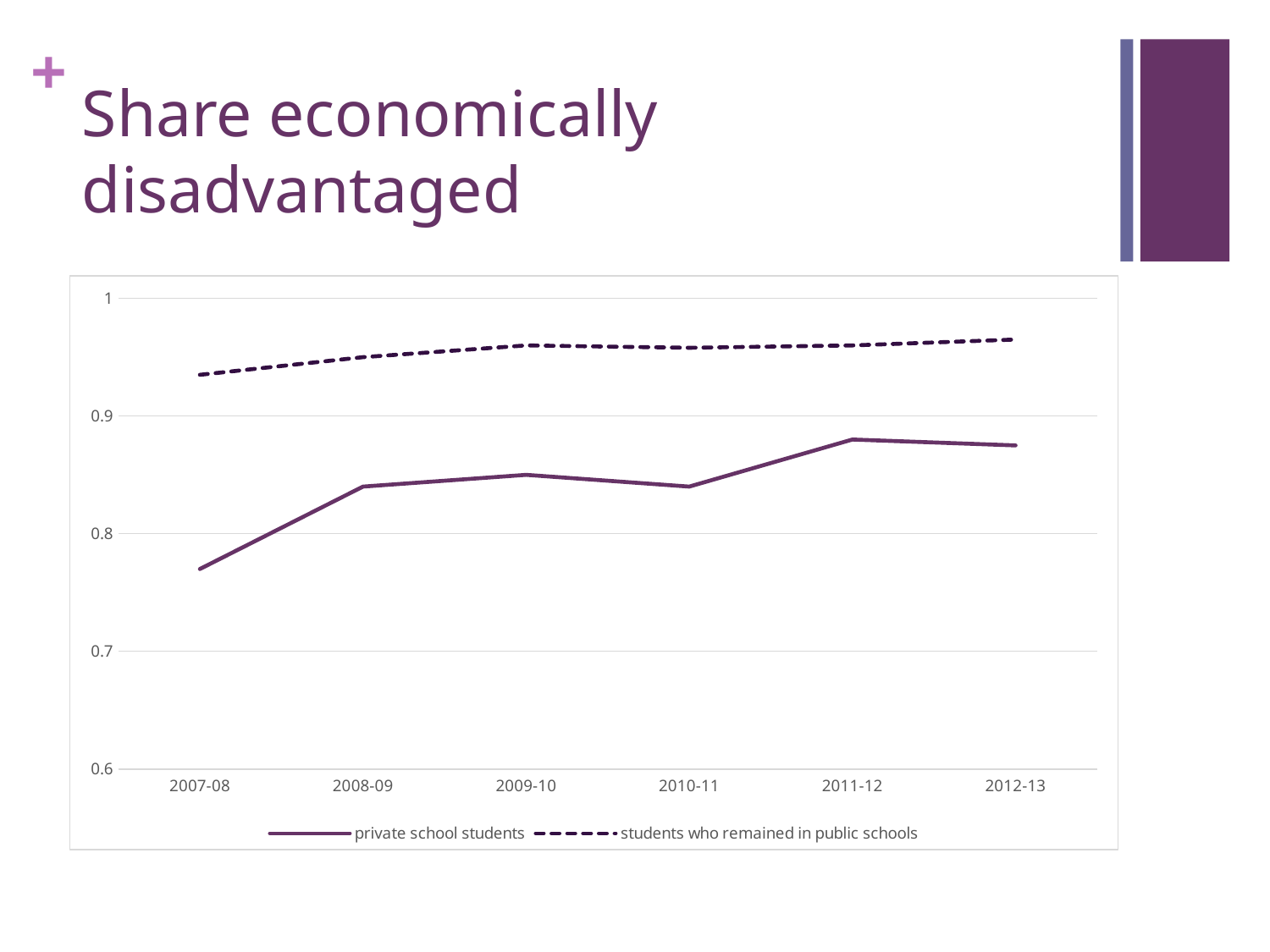
Is the value for private school students in 2007-08 greater or less than 0.8? less Which series is drawn with a dashed line? students who remained in public schools Does the value for private school students rise or fall from 2007-08 to 2012-13? rise How many series does the legend list? 2 Is the value for private school students in 2008-09 greater or less than 0.8? greater In which school year is the value for private school students lowest? 2007-08 How many school years are plotted along the x axis? 6 Is the value for private school students in 2011-12 greater or less than 0.9? less What kind of chart is shown on the slide? line chart In which school year is the value for students who remained in public schools lowest? 2007-08 In 2010-11, which series has the larger value: private school students or students who remained in public schools? students who remained in public schools